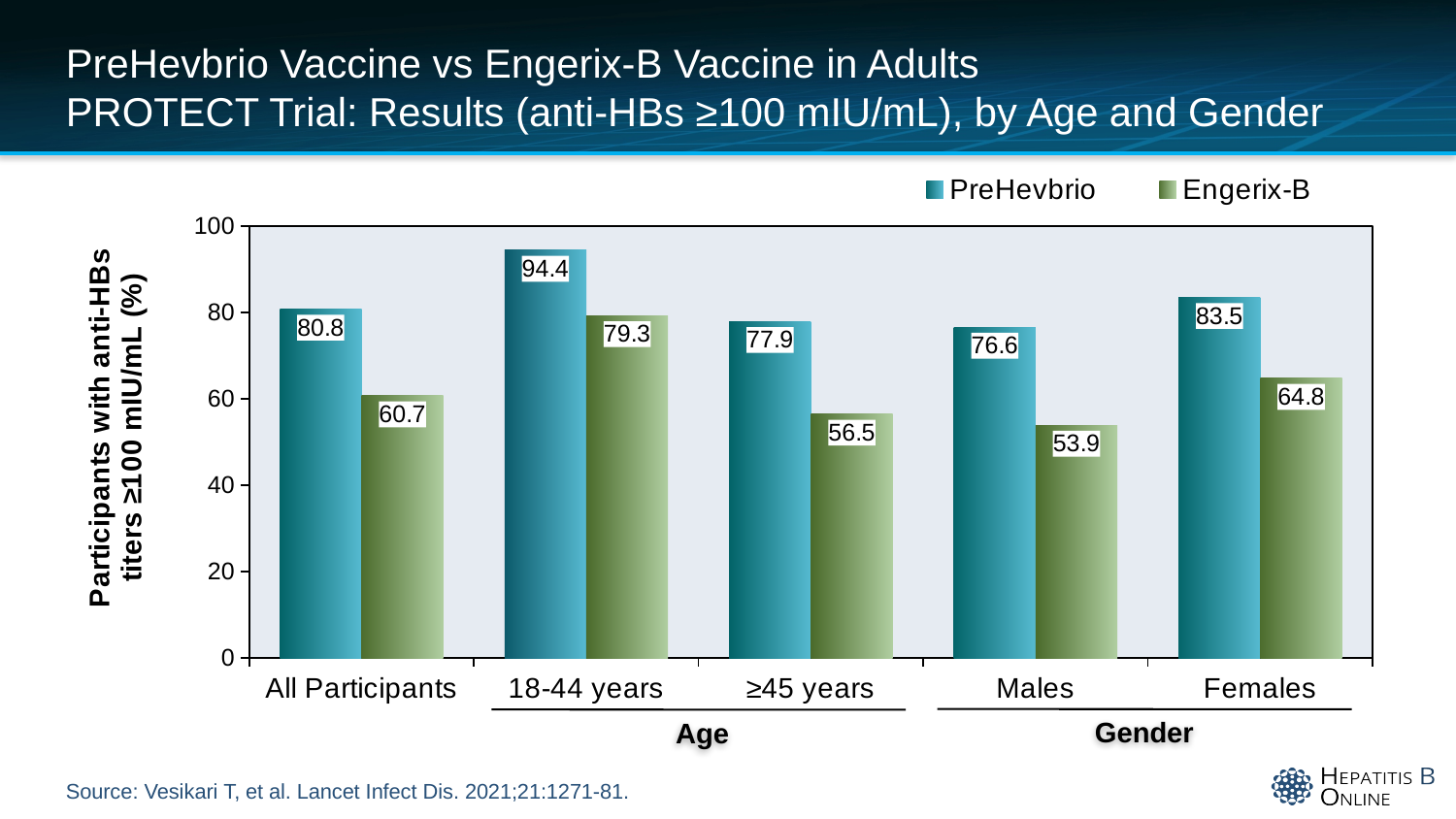
Is the PreHevbrio value for Males greater or less than 80? less How many categories are shown on the x axis? 5 Which category has the lowest Engerix-B value? Males What is the difference between the PreHevbrio and Engerix-B values for Females? 18.7 How many series does the legend list? 2 What is the difference between the PreHevbrio values for 18-44 years and ≥45 years? 16.5 What is the PreHevbrio value for All Participants? 80.8 Which category has the highest PreHevbrio value? 18-44 years What kind of chart is shown on the slide? bar chart What is the Engerix-B value for Males? 53.9 Which is larger, the Engerix-B value for Females or the Engerix-B value for ≥45 years? Females What is the Engerix-B value for the 18-44 years group? 79.3